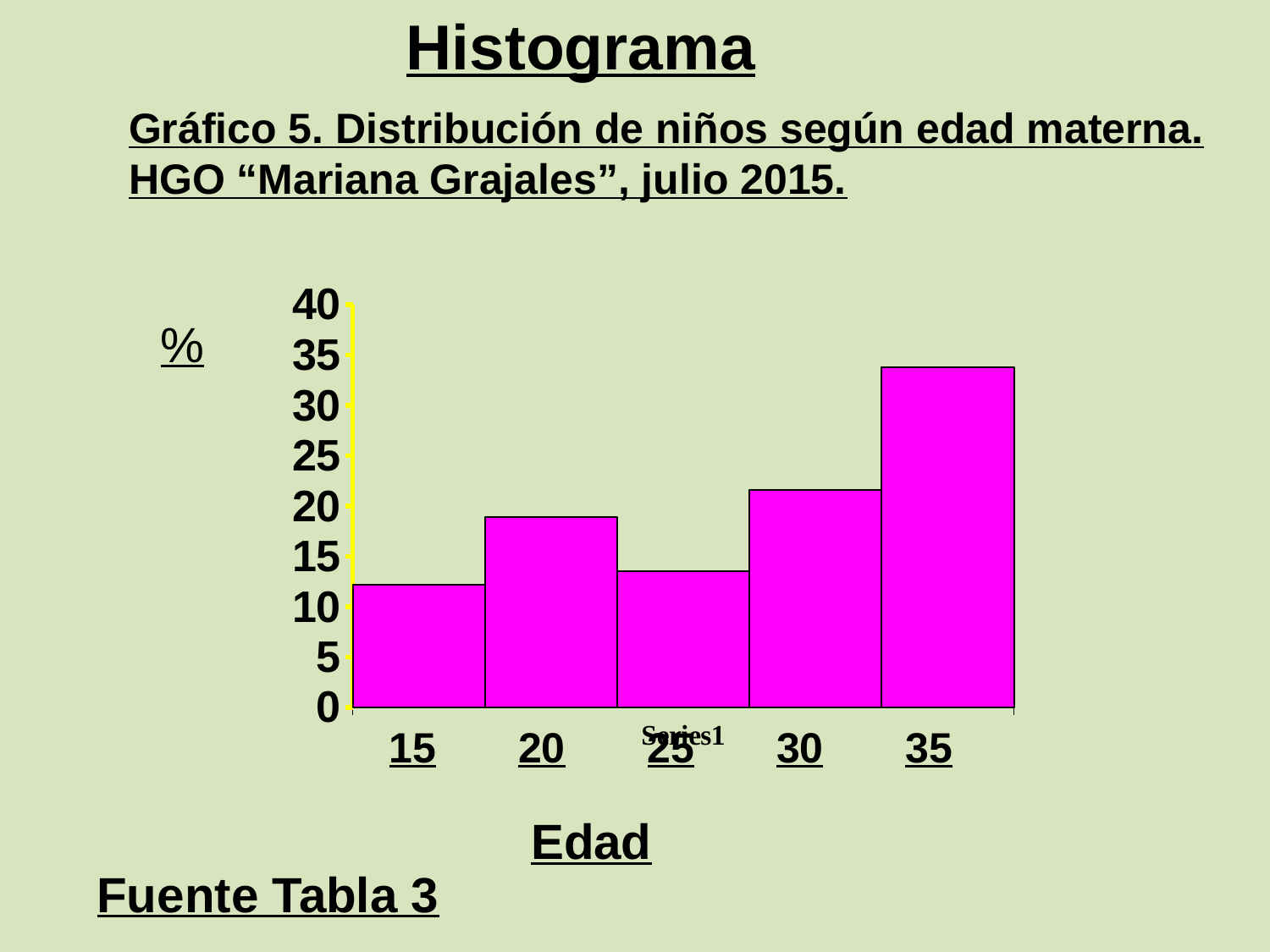
What is the title of the chart (Gráfico 5)? Distribución de niños según edad materna. HGO "Mariana Grajales", julio 2015. Is the value for age 15 greater or less than 15? less Which age category has the lowest percentage? 15 Is the value for age 30 greater or less than 20? greater Is the value for age 25 greater or less than 15? less Which age category has the highest percentage? 35 Which has a larger value, age 20 or age 25? 20 What is the label of the x axis? Edad What kind of chart is shown on the slide? bar chart (histogram) How many bars (age categories) are plotted in the chart? 5